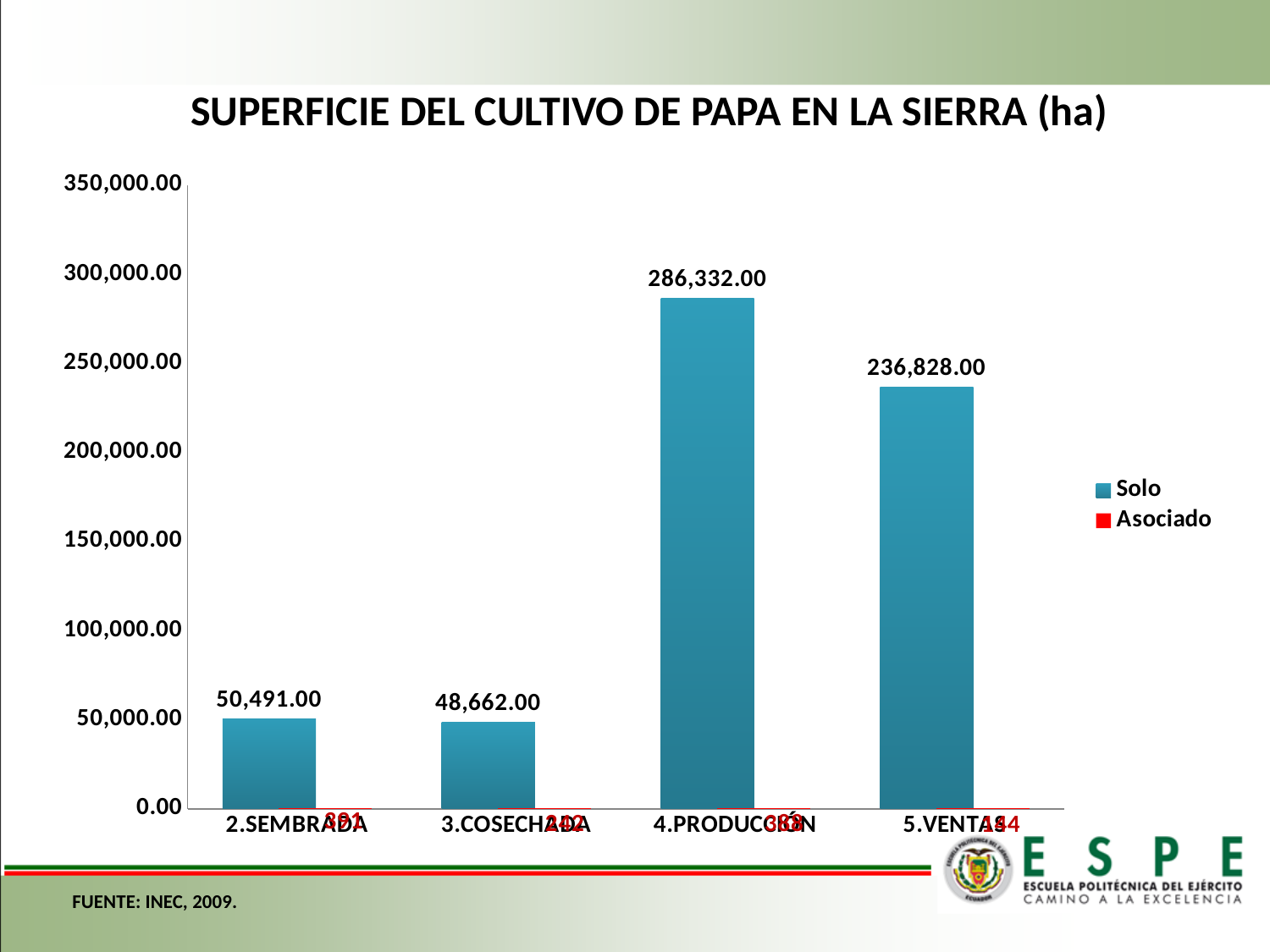
Is the Solo value for 5.VENTAS greater or less than 200,000.00? greater What is the Solo value for 3.COSECHADA? 48,662.00 What is the title of the chart? SUPERFICIE DEL CULTIVO DE PAPA EN LA SIERRA (ha) Which has a larger Solo value, 5.VENTAS or 2.SEMBRADA? 5.VENTAS What is the difference between the Solo values for 4.PRODUCCIÓN and 5.VENTAS? 49,504.00 How many series does the legend list? 2 Which category has the lowest Solo value? 3.COSECHADA What is the Solo value for 4.PRODUCCIÓN? 286,332.00 What is the difference between the Solo values for 2.SEMBRADA and 3.COSECHADA? 1,829.00 What is the Solo value for 5.VENTAS? 236,828.00 Which category has the highest Solo value? 4.PRODUCCIÓN What is the Solo value for 2.SEMBRADA? 50,491.00